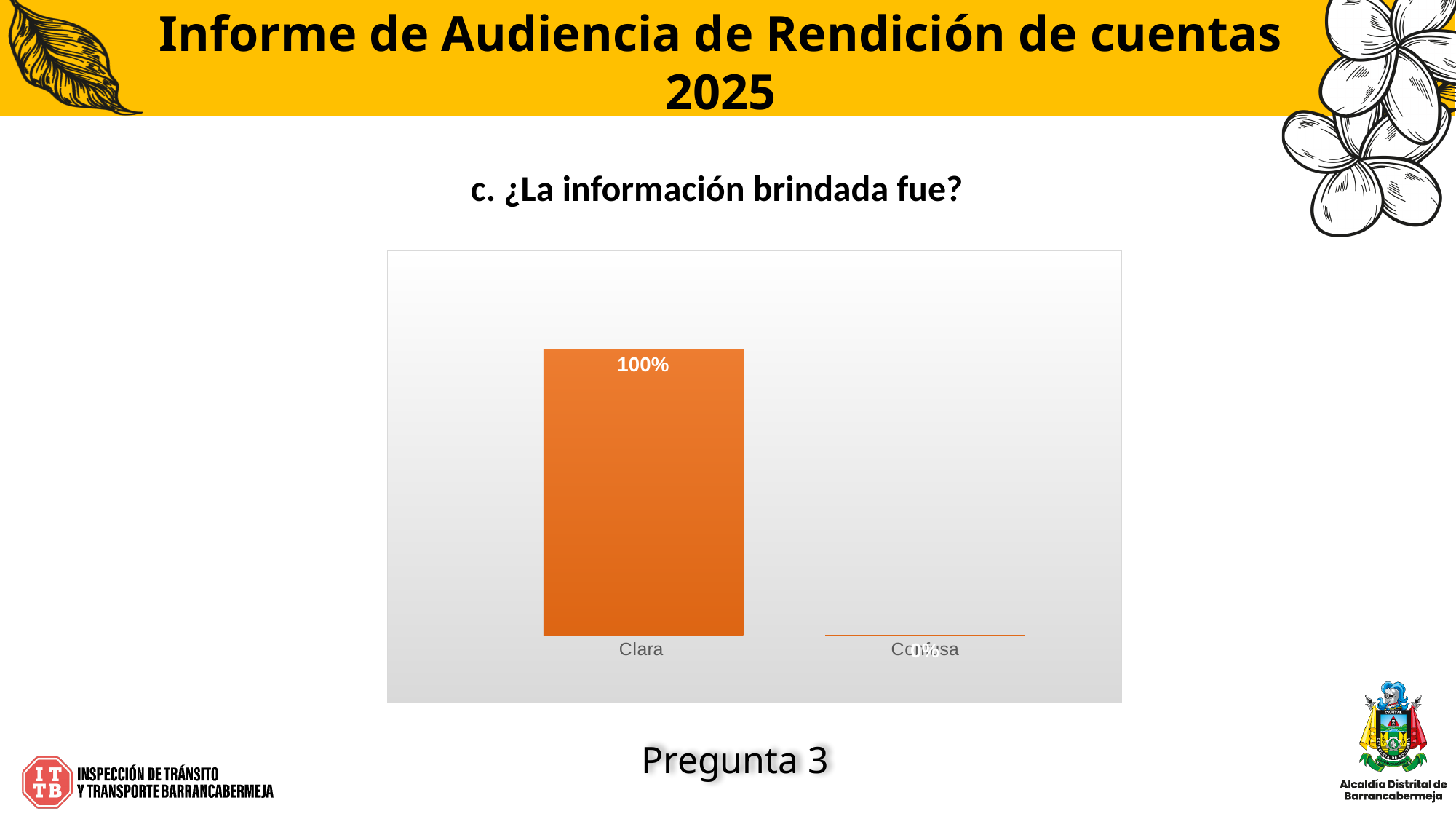
What is the value for Confusa? 0% Which category has the lowest value? Confusa Which is larger, the value for Clara or the value for Confusa? Clara Which category has the highest value? Clara What colour is the bar for Clara? Orange What kind of chart is shown on the slide? Bar chart What question does the chart answer, as written above it? c. ¿La información brindada fue? What is the value for Clara? 100% How many categories are shown on the x axis? 2 Do the values rise or fall from Clara to Confusa along the x axis? Fall What is the difference between the value for Clara and the value for Confusa? 100%